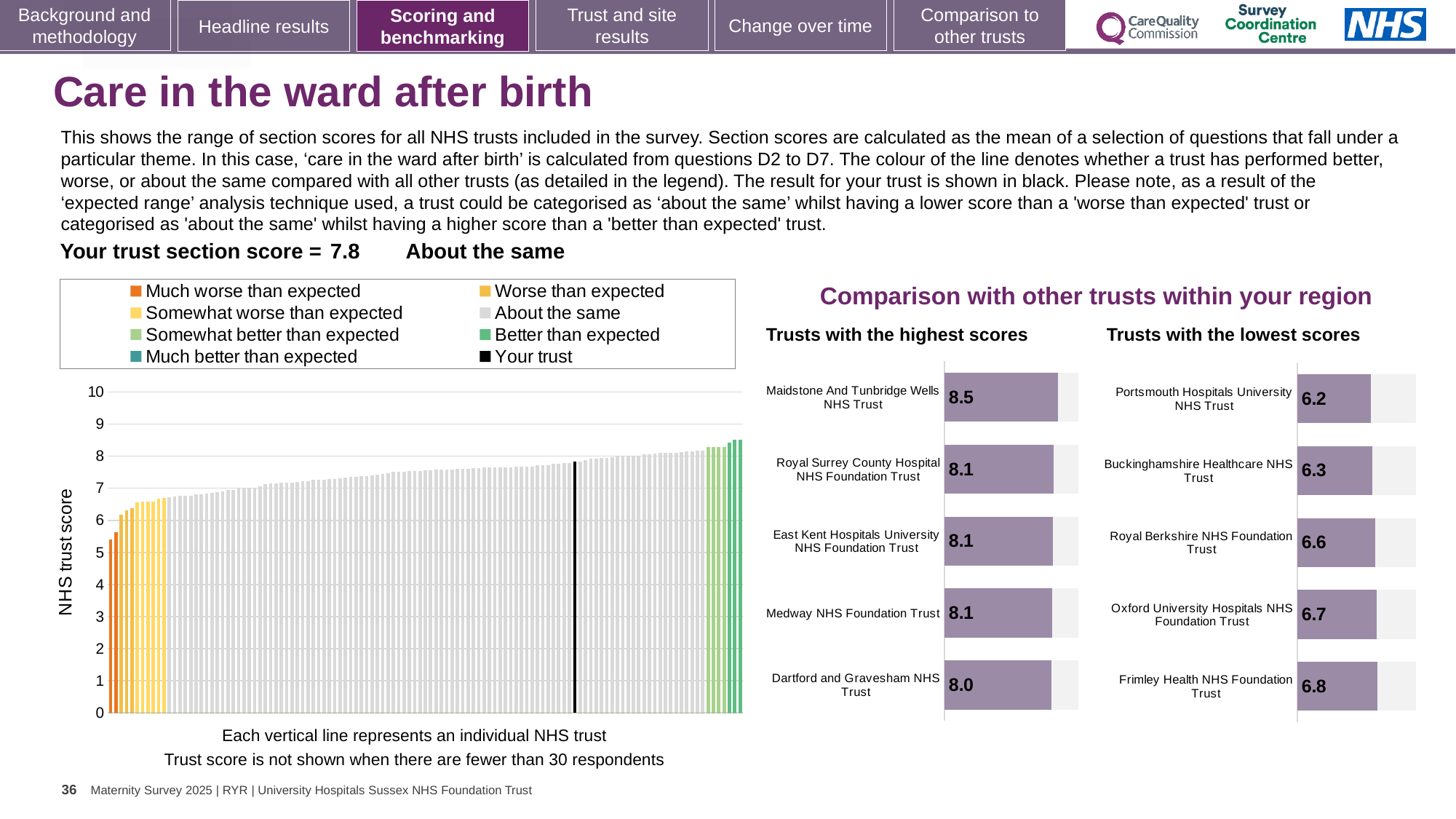
In the 'Trusts with the lowest scores' chart, which has the higher score: Royal Berkshire NHS Foundation Trust or Oxford University Hospitals NHS Foundation Trust? Oxford University Hospitals NHS Foundation Trust How many trusts are shown in the 'Trusts with the highest scores' chart? 5 In the large chart on the left, is the value for 'Your trust' (the black bar) greater or less than 7? greater In the 'Trusts with the highest scores' chart, what is the difference between the scores of Maidstone And Tunbridge Wells NHS Trust and Dartford and Gravesham NHS Trust? 0.5 In the 'Trusts with the highest scores' chart, what is the score for Maidstone And Tunbridge Wells NHS Trust? 8.5 In the 'Trusts with the highest scores' chart, which trust has the highest score? Maidstone And Tunbridge Wells NHS Trust In the large chart on the left, do the NHS trust scores rise or fall from left to right? Rise What kind of chart is the large chart on the left showing NHS trust scores? Bar chart In the 'Trusts with the lowest scores' chart, which trust has the lowest score? Portsmouth Hospitals University NHS Trust In the 'Trusts with the lowest scores' chart, what is the difference between the scores of Frimley Health NHS Foundation Trust and Portsmouth Hospitals University NHS Trust? 0.6 How many entries does the legend above the large chart on the left list? 8 In the 'Trusts with the lowest scores' chart, what is the score for Portsmouth Hospitals University NHS Trust? 6.2